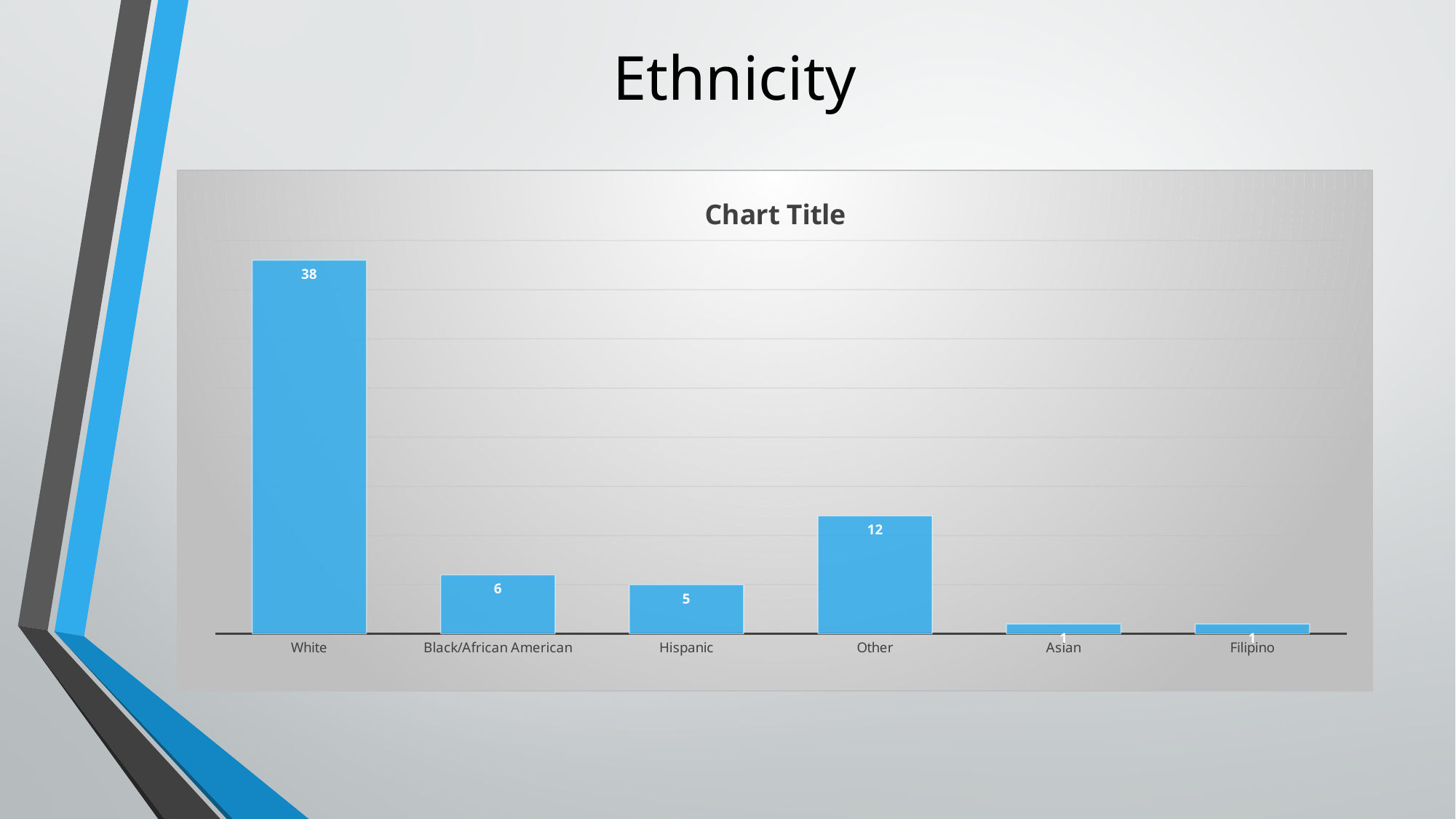
What is the title shown inside the chart area? Chart Title What is the difference between the values for Black/African American and Hispanic? 1 Which is larger, the value for Other or the value for Black/African American? Other What is the title of the slide? Ethnicity What kind of chart is shown on the slide? Bar chart What is the value for Black/African American? 6 What is the value for Other? 12 Which category has the highest value? White What is the difference between the values for White and Other? 26 What is the value for White? 38 How many categories are shown on the x axis? 6 What is the value for Hispanic? 5